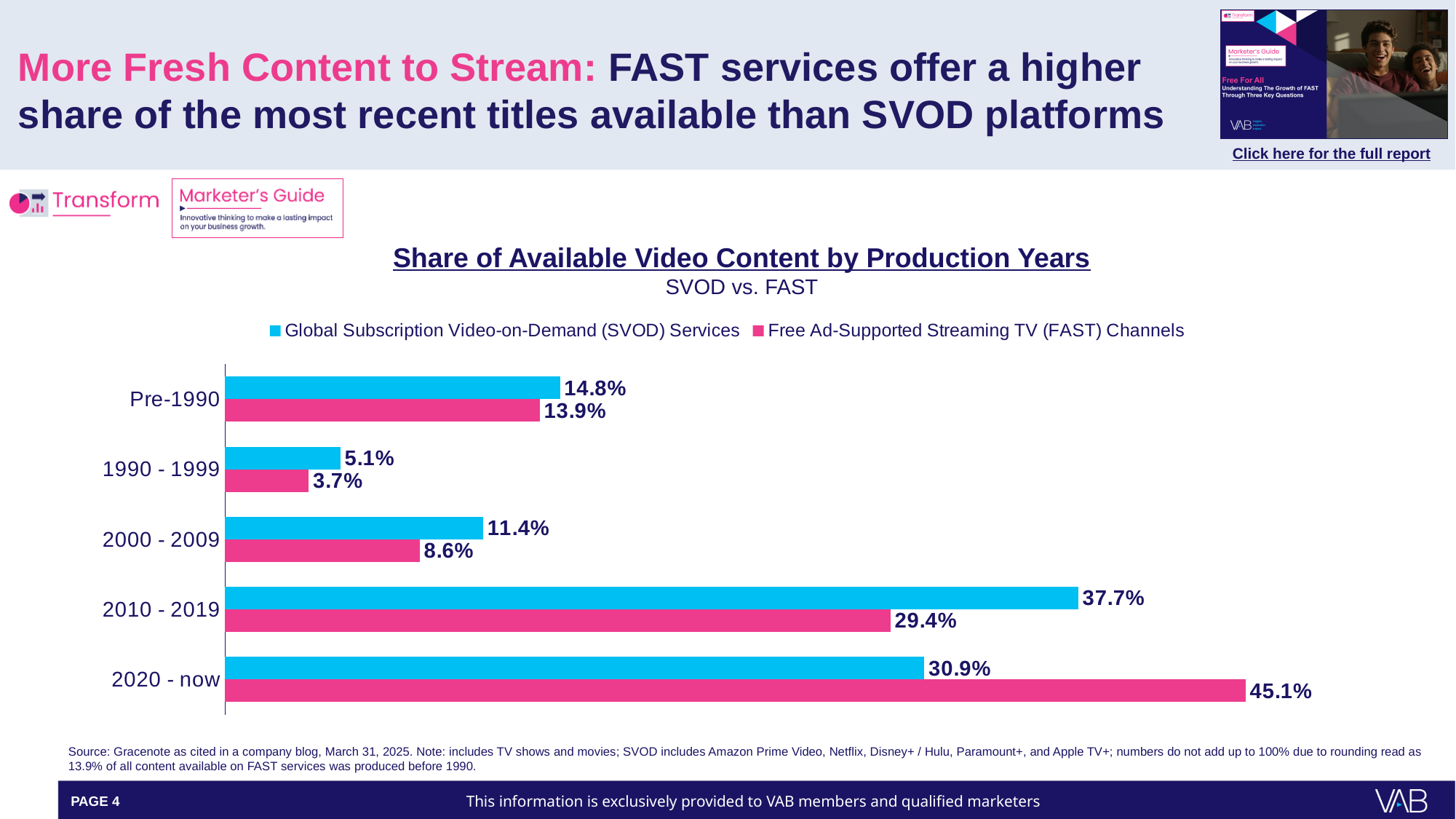
Which production-year category has the lowest SVOD share? 1990 - 1999 What is the FAST share for the 2020 - now production years? 45.1% What is the SVOD share for the 2010 - 2019 production years? 37.7% What is the title of the chart? Share of Available Video Content by Production Years What is the SVOD share for Pre-1990 content? 14.8% What is the difference between the FAST and SVOD shares for 2020 - now? 14.2% How many series does the legend list? 2 What kind of chart is shown on the slide? Bar chart For 2000 - 2009, which is larger: the SVOD share or the FAST share? SVOD share What is the FAST share for the 1990 - 1999 production years? 3.7% How many production-year categories are shown on the chart? 5 Which production-year category has the highest FAST share? 2020 - now